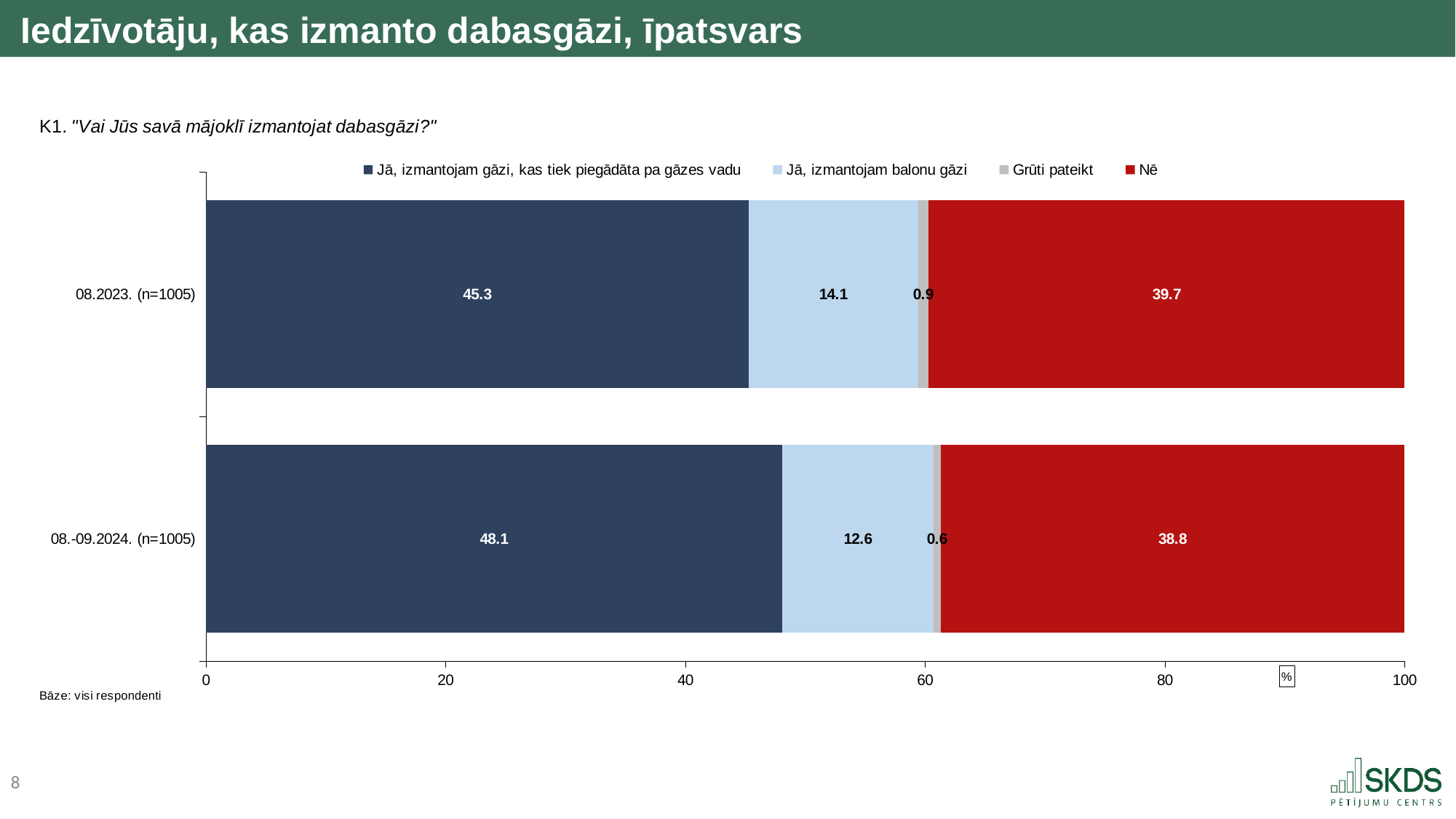
What is the value for "Jā, izmantojam balonu gāzi" in 08.-09.2024. (n=1005)? 12.6 Which is larger: the "Nē" value for 08.2023. (n=1005) or for 08.-09.2024. (n=1005)? 08.2023. (n=1005) What is the total of the stacked bar for 08.2023. (n=1005)? 100.0 What kind of chart is shown on the slide? Stacked bar chart How many categories (bars) are shown in the chart? 2 What is the value for "Grūti pateikt" in 08.2023. (n=1005)? 0.9 What is the value for "Jā, izmantojam gāzi, kas tiek piegādāta pa gāzes vadu" in 08.2023. (n=1005)? 45.3 Which series has the lowest value in the 08.2023. (n=1005) bar? Grūti pateikt What is the value for "Nē" in 08.-09.2024. (n=1005)? 38.8 What is the difference between the "Jā, izmantojam gāzi, kas tiek piegādāta pa gāzes vadu" values for 08.-09.2024. (n=1005) and 08.2023. (n=1005)? 2.8 How many series does the legend list? 4 Which series has the highest value in the 08.-09.2024. (n=1005) bar? Jā, izmantojam gāzi, kas tiek piegādāta pa gāzes vadu